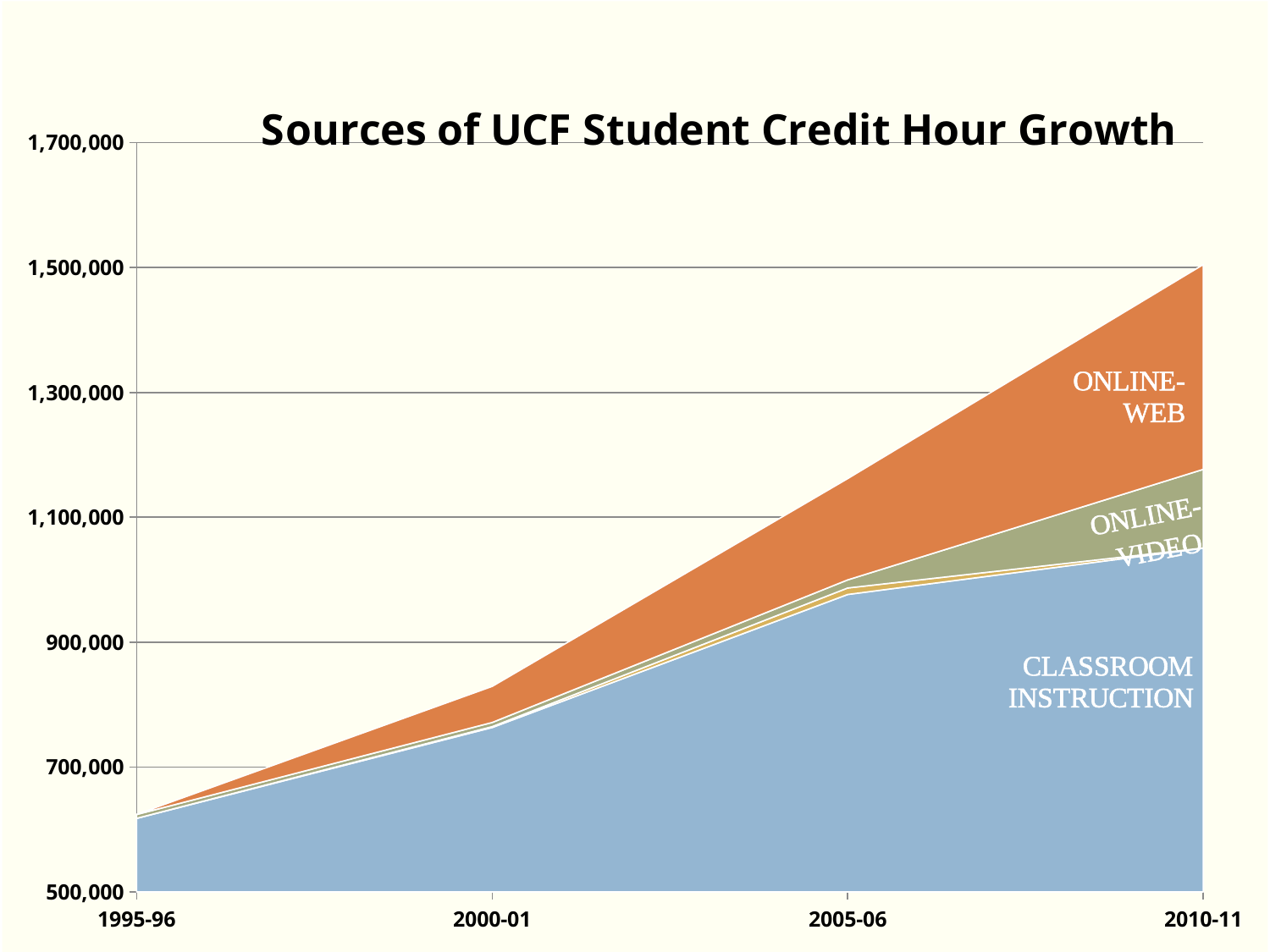
Is the total student credit hours in 1995-96 greater or less than 700,000? less Is the value for Classroom Instruction in 2000-01 greater or less than 700,000? greater Is the total student credit hours in 2005-06 greater or less than 900,000? greater How many academic years are plotted along the x axis? 4 What is the title of the chart? Sources of UCF Student Credit Hour Growth What kind of chart is shown on the slide? Stacked area chart Which academic year has the lowest total student credit hours? 1995-96 Which academic year has the highest total student credit hours? 2010-11 Which source accounts for the largest share of student credit hours in 2010-11? Classroom Instruction Does the total student credit hours rise or fall from 1995-96 to 2010-11? Rise